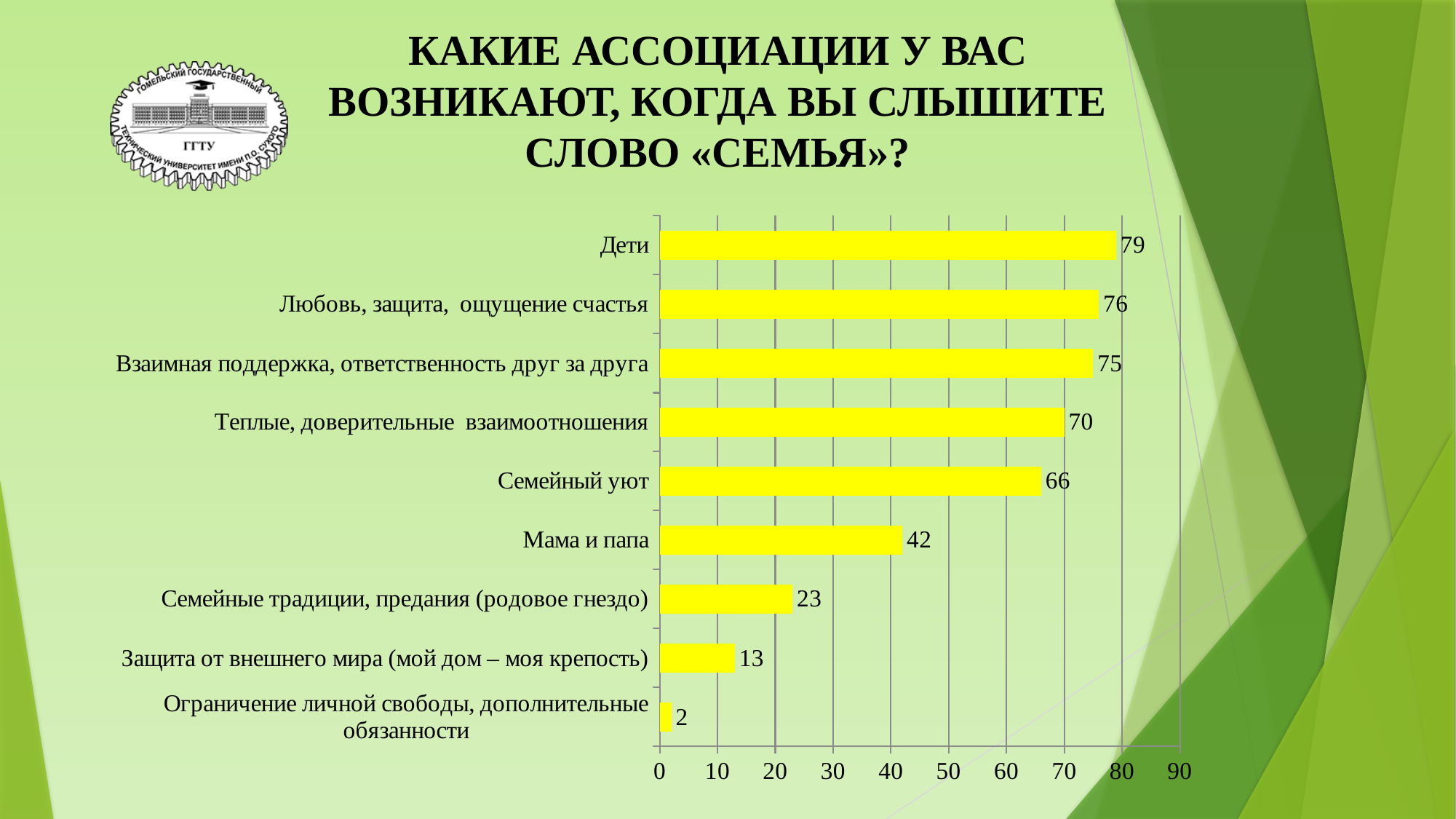
What is the value for «Взаимная поддержка, ответственность друг за друга»? 75 What is the difference between the values for «Дети» and «Мама и папа»? 37 What is the value for «Семейный уют»? 66 How many categories are shown in the chart? 9 Which category has the highest value? Дети Which category has the lowest value? Ограничение личной свободы, дополнительные обязанности What colour are the bars in the chart? yellow What is the value for «Мама и папа»? 42 What is the value for «Дети»? 79 What kind of chart is shown on the slide? bar chart Is the value for «Теплые, доверительные взаимоотношения» greater or less than 60? greater Which is larger: the value for «Семейные традиции, предания (родовое гнездо)» or the value for «Защита от внешнего мира (мой дом – моя крепость)»? Семейные традиции, предания (родовое гнездо)